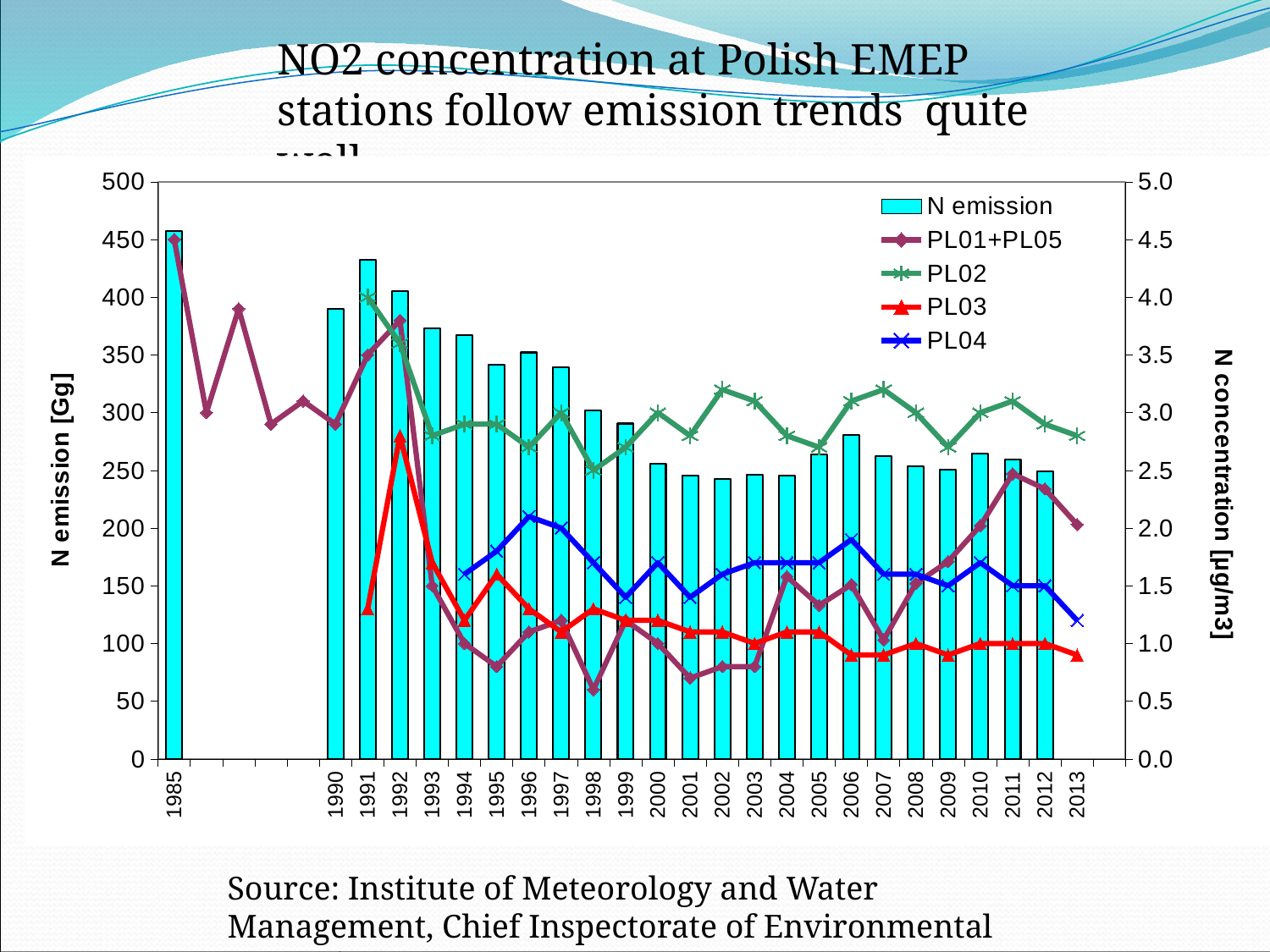
Is the N emission value for 2012 greater or less than 300? less Is the PL02 value for 2013 greater or less than 3.0? less Is the PL04 value for 2013 greater or less than 1.5? less How many series does the legend list? 5 What is the label of the right-hand vertical axis? N concentration [µg/m3] Do the N emission bars generally rise or fall from 1991 to 2012? fall What kind of chart is this? Combination bar and line chart In 2010, which is larger, the PL02 value or the PL03 value? PL02 Which year has the highest N emission bar? 1985